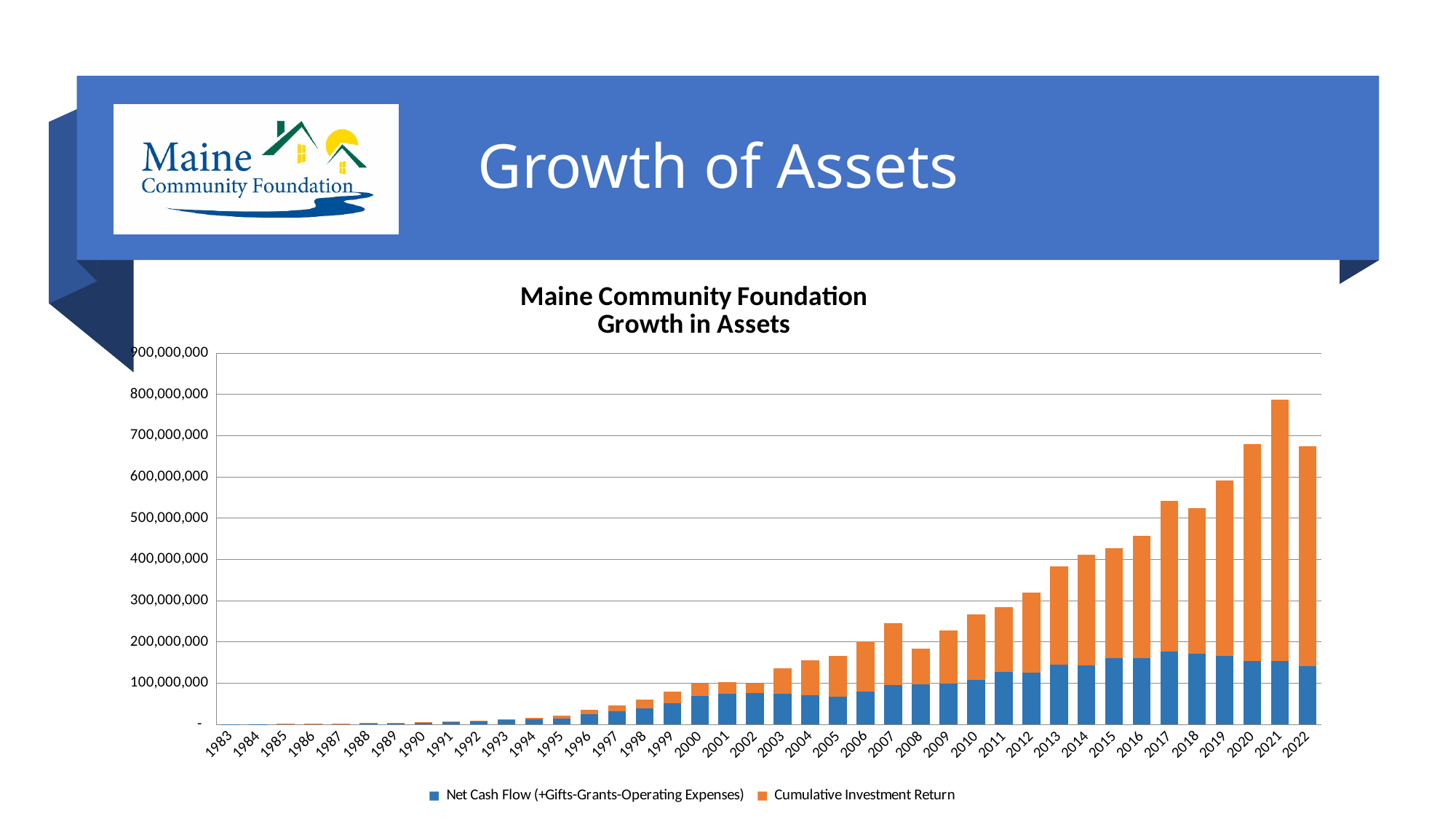
Is the total stacked bar for 2017 greater or less than 500,000,000? greater Is the total stacked bar for 2020 greater or less than 600,000,000? greater Is the total stacked bar for 2021 greater or less than 700,000,000? greater How many series does the legend list? 2 Which year has the larger total stacked bar, 2021 or 2022? 2021 How many years are shown along the x axis? 40 Overall, do the stacked bar totals rise or fall from 1983 to 2022? Rise Which series is shown in orange in the legend? Cumulative Investment Return What kind of chart is shown on the slide? Stacked bar chart Which year has the tallest stacked bar? 2021 Which year has the larger total stacked bar, 2007 or 2008? 2007